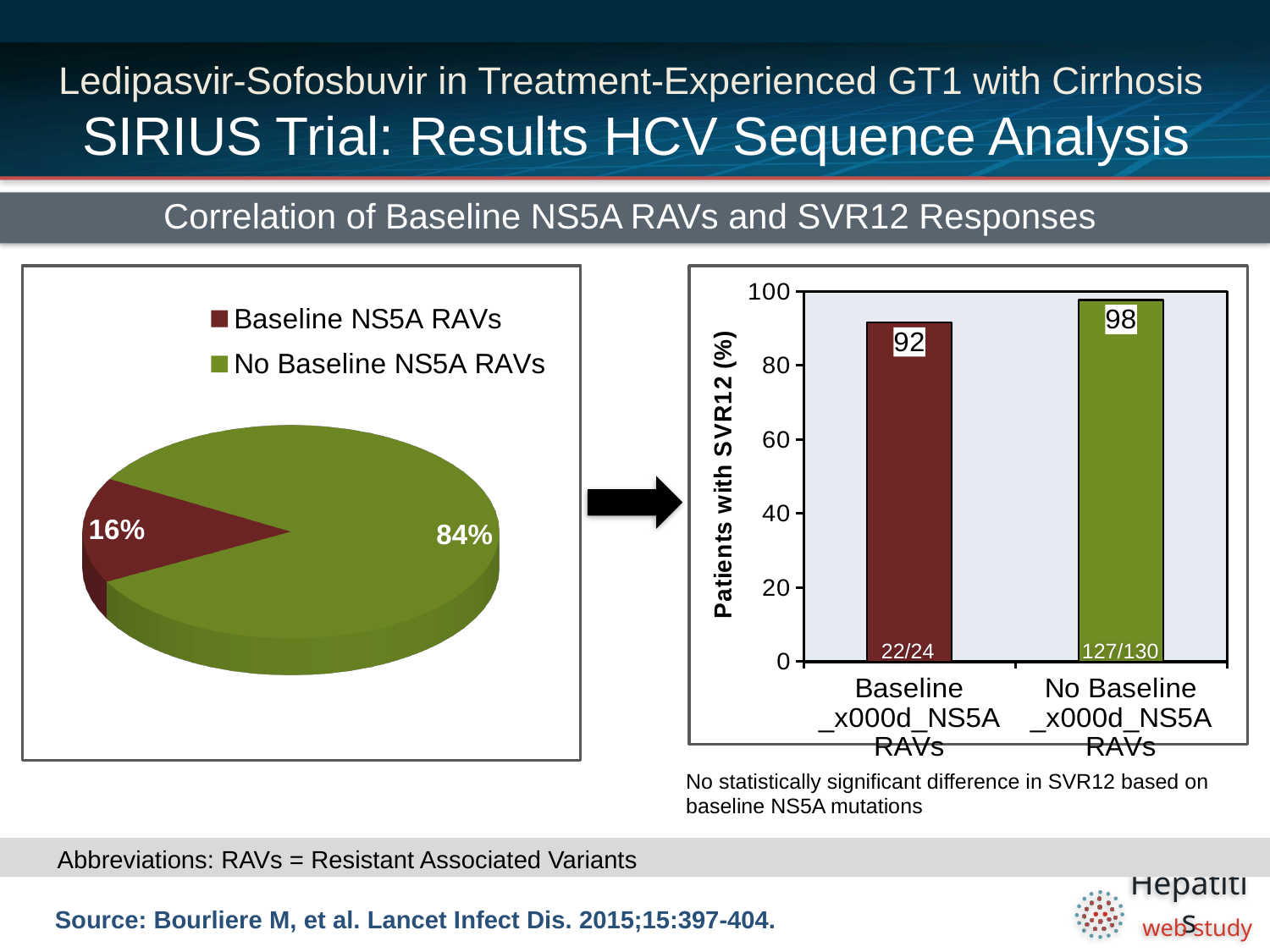
In the bar chart on the right, what is the value for No Baseline NS5A RAVs? 98 In the pie chart on the left, how many entries does the legend list? 2 In the bar chart on the right, what is the label of the vertical axis? Patients with SVR12 (%) In the bar chart on the right, which category has the highest value? No Baseline NS5A RAVs In the pie chart on the left, how many slices does the pie have? 2 In the bar chart on the right, what is the difference between the No Baseline NS5A RAVs value and the Baseline NS5A RAVs value? 6 In the bar chart on the right, what is the value for Baseline NS5A RAVs? 92 In the pie chart on the left, what share of the pie is labelled Baseline NS5A RAVs? 16% In the pie chart on the left, which slice is larger, Baseline NS5A RAVs or No Baseline NS5A RAVs? No Baseline NS5A RAVs In the pie chart on the left, what share of the pie is labelled No Baseline NS5A RAVs? 84% In the bar chart on the right, what fraction is printed at the base of the No Baseline NS5A RAVs bar? 127/130 What kind of chart is shown on the left side of the slide? Pie chart